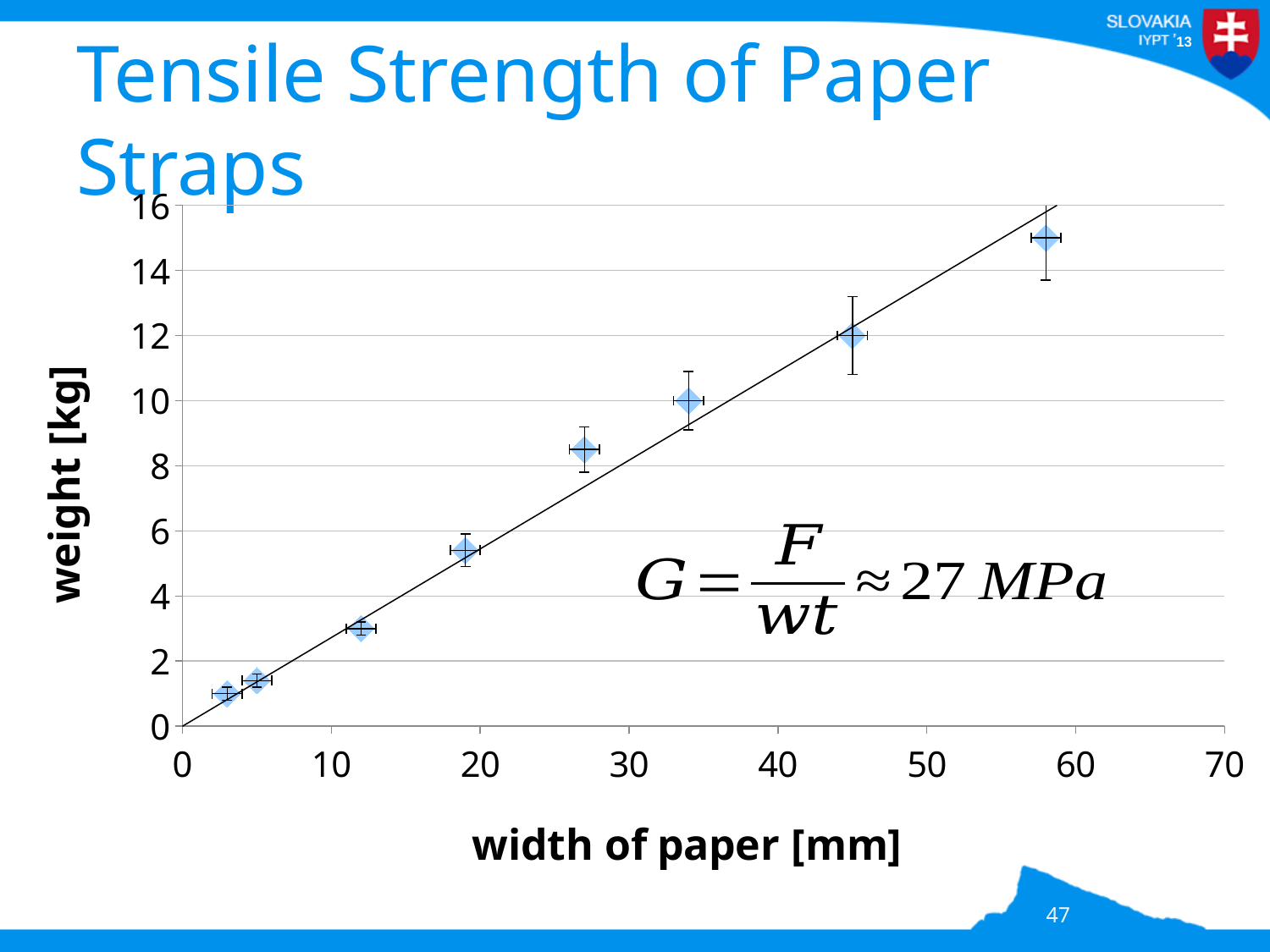
Which is larger: the weight at the point near 27 mm width or the weight at the point near 45 mm width? the point near 45 mm Do the weight values rise or fall as the width of paper increases? rise Is the weight for the data point at the largest width (near 58 mm) greater or less than 14 kg? greater Is the weight for the data point near 19 mm width greater or less than 4 kg? greater Is the weight for the data point near 34 mm width greater or less than 8 kg? greater What approximate value of G is given in the formula on the chart? 27 MPa Does the highest weight occur at the largest or the smallest width of paper? largest What is the label of the vertical axis? weight [kg] How many data points are plotted on the chart? 8 What kind of chart is shown on the slide? scatter chart